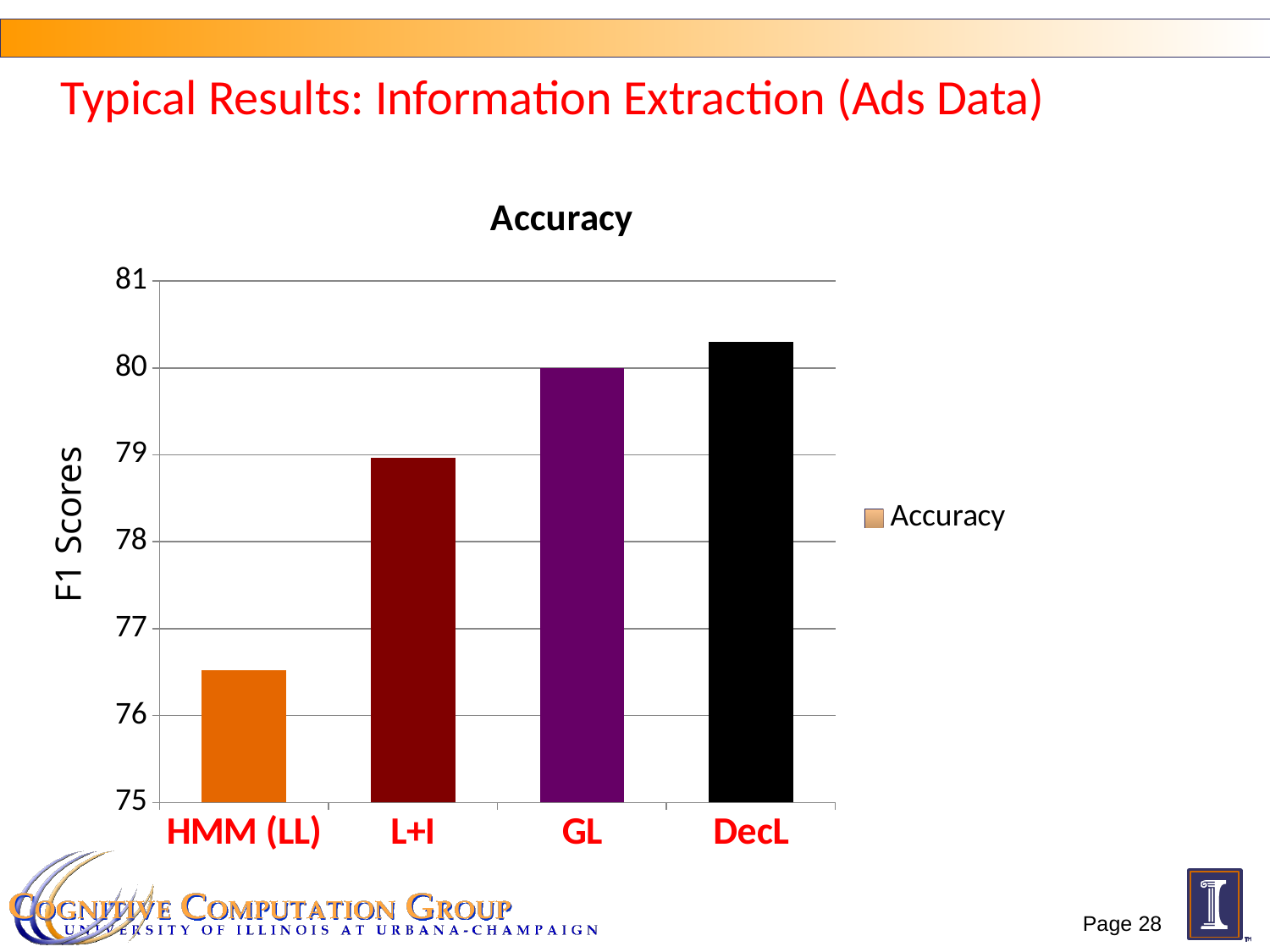
Is the value for HMM (LL) greater or less than 77? less Which has a higher F1 score, L+I or GL? GL Do the F1 scores rise or fall from left to right across the categories? rise How many categories are shown on the x axis of the Accuracy chart? 4 Is the value for L+I greater or less than 78? greater How many series does the legend list? 1 Which has a higher F1 score, HMM (LL) or L+I? L+I Which category has the highest F1 score? DecL What is the label on the y axis of the chart? F1 Scores Is the value for DecL greater or less than 80? greater What kind of chart is shown on the slide? bar chart Which category has the lowest F1 score? HMM (LL)